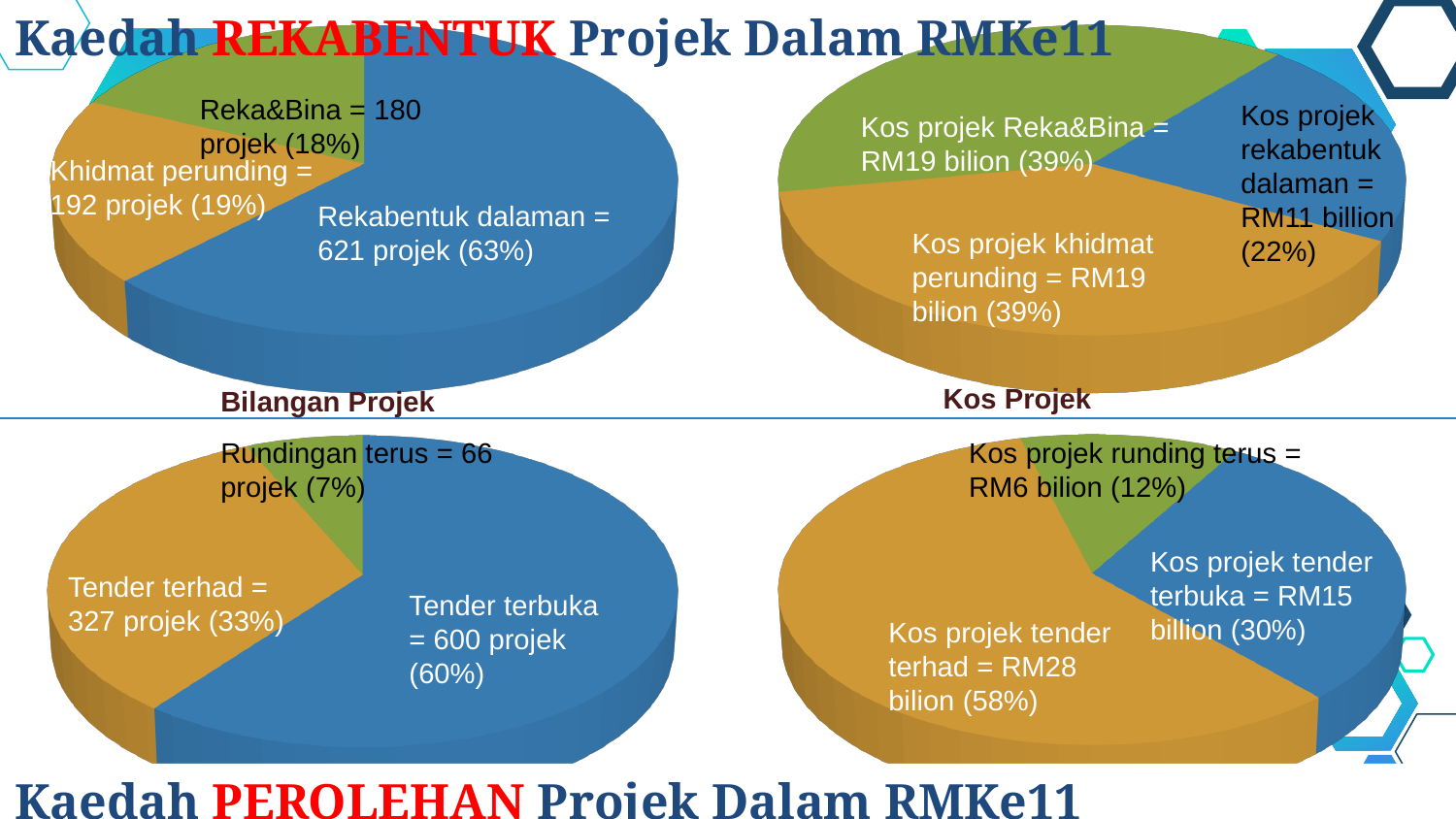
In the top-left pie chart (Bilangan Projek), which category has the smallest number of projects? Reka&Bina In the top-right pie chart (Kos Projek), what is the cost of Reka&Bina projects? RM19 bilion In the bottom-left pie chart (Kaedah Perolehan, number of projects), which is larger: Tender terhad or Rundingan terus? Tender terhad In the top-right pie chart (Kos Projek), what share of cost is rekabentuk dalaman? 22% In the top-right pie chart (Kos Projek), which category has the lowest project cost? Kos projek rekabentuk dalaman In the bottom-left pie chart (Kaedah Perolehan, number of projects), how many projects used Tender terbuka? 600 projek In the top-left pie chart (Bilangan Projek), what is the difference in number of projects between Rekabentuk dalaman and Khidmat perunding? 429 projek In the bottom-right pie chart (Kaedah Perolehan, cost), what is the cost of tender terhad projects? RM28 bilion In the bottom-right pie chart (Kaedah Perolehan, cost), what is the difference between the cost of tender terhad and tender terbuka projects? RM13 billion In the top-left pie chart (Bilangan Projek), how many projects used Rekabentuk dalaman? 621 projek In the top-left pie chart (Bilangan Projek), what share of projects is Khidmat perunding? 19% How many slices does the bottom-right pie chart (Kaedah Perolehan, cost) have? 3